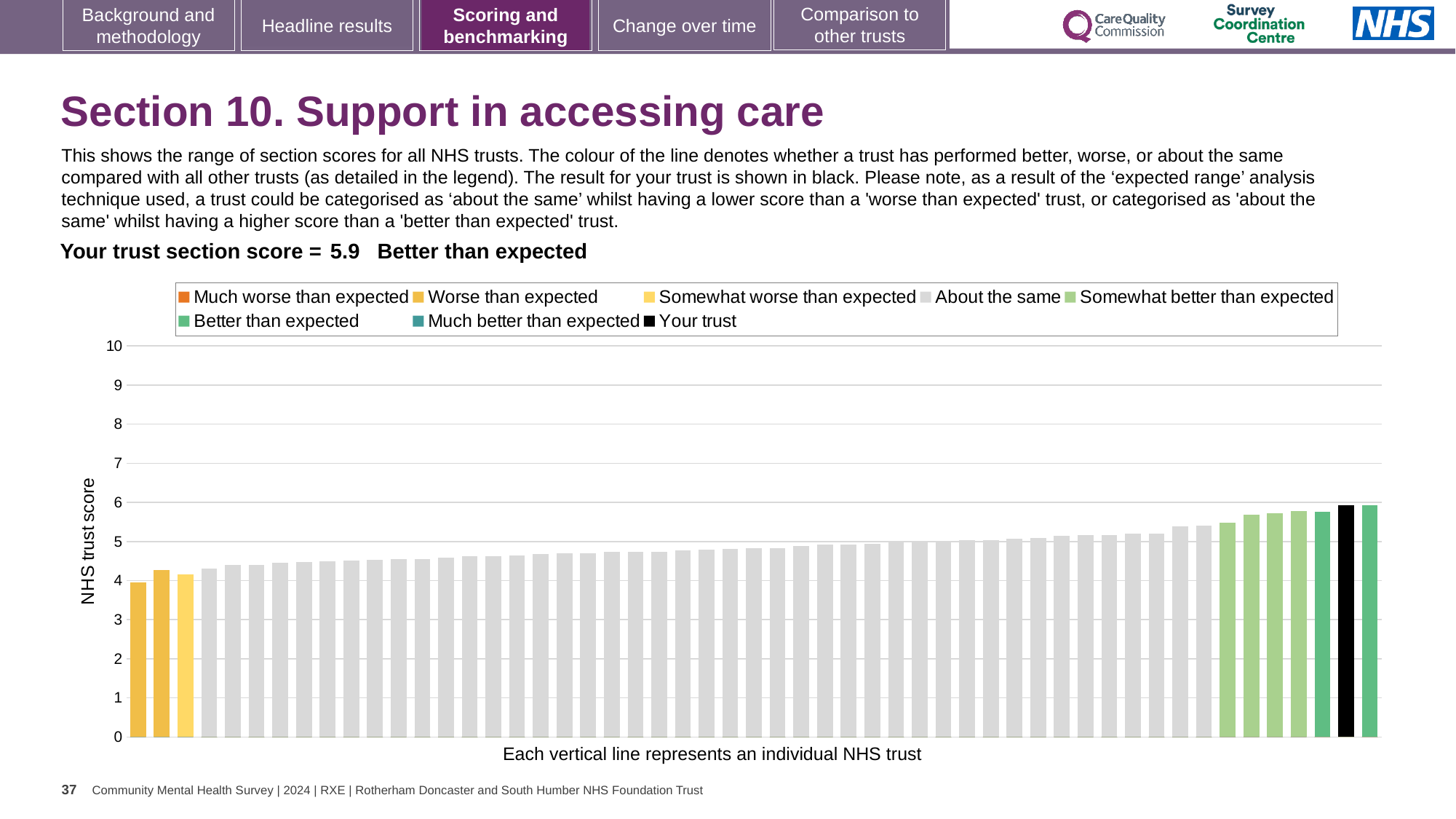
What colour is the bar representing your trust? black Is the value for your trust greater or less than 7? less What is the label on the vertical axis of the chart? NHS trust score How many entries does the chart legend list? 8 What kind of chart is shown on the slide? bar chart What is your trust's section score for Section 10, Support in accessing care? 5.9 Is the value of the lowest bar on the chart greater or less than 3? greater What is the maximum value shown on the vertical axis? 10 Is the value for your trust greater or less than 5? greater How is your trust's section score categorised compared with other trusts? Better than expected Do the bar values rise or fall from left to right along the x axis? rise